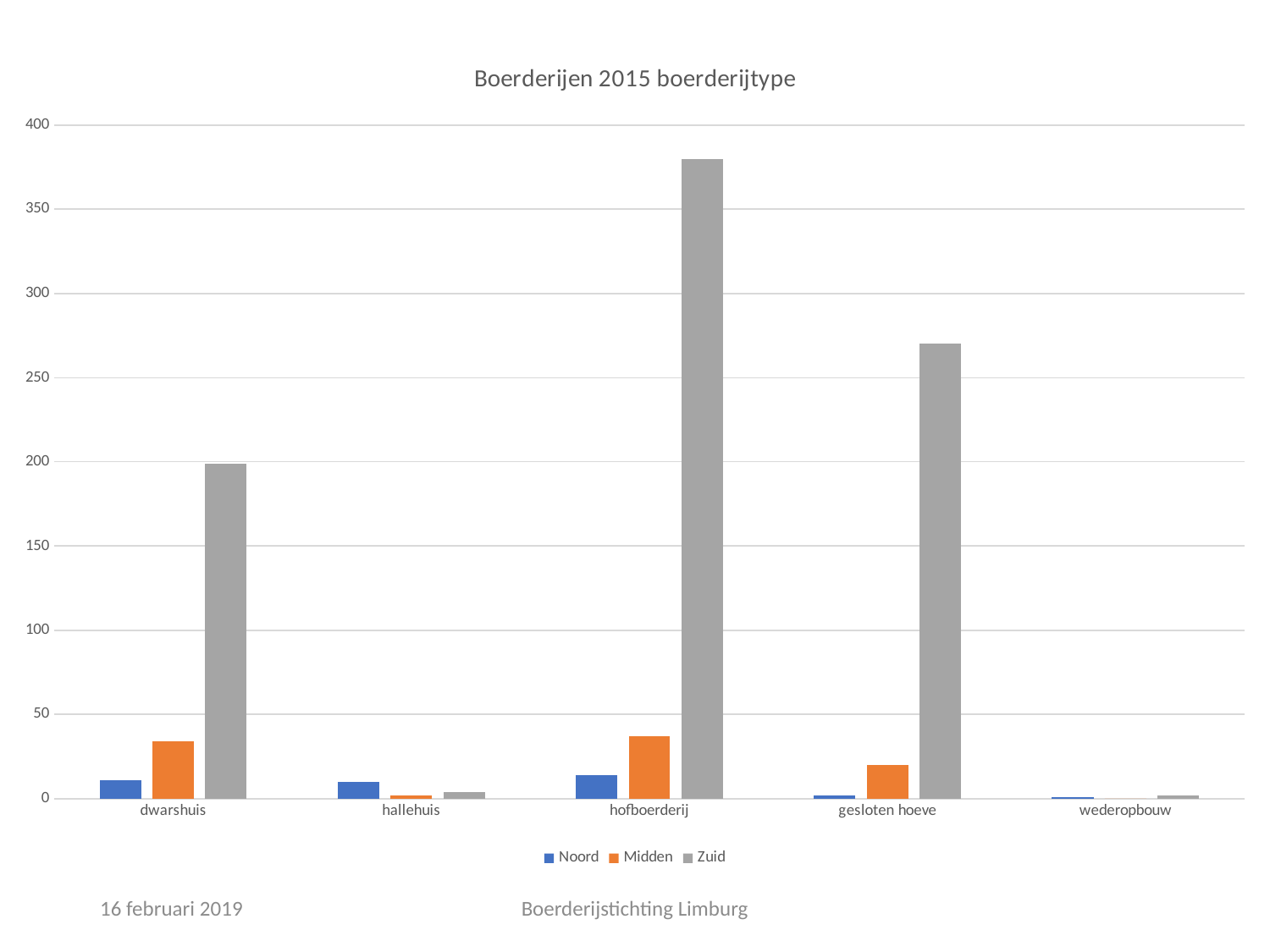
Which colour represents the Zuid series in the legend? grey Is the Zuid value for gesloten hoeve greater or less than 250? greater How many farm-type categories are shown on the x axis? 5 Which category has the highest value for the Zuid series? hofboerderij What is the title of the chart? Boerderijen 2015 boerderijtype Is the Zuid value for dwarshuis greater or less than 150? greater Is the Zuid value for hofboerderij greater or less than 350? greater For dwarshuis, which series is larger: Noord or Midden? Midden Which is larger: the Zuid value for gesloten hoeve or the Zuid value for dwarshuis? gesloten hoeve How many series does the legend list? 3 What kind of chart is shown on the slide? bar chart